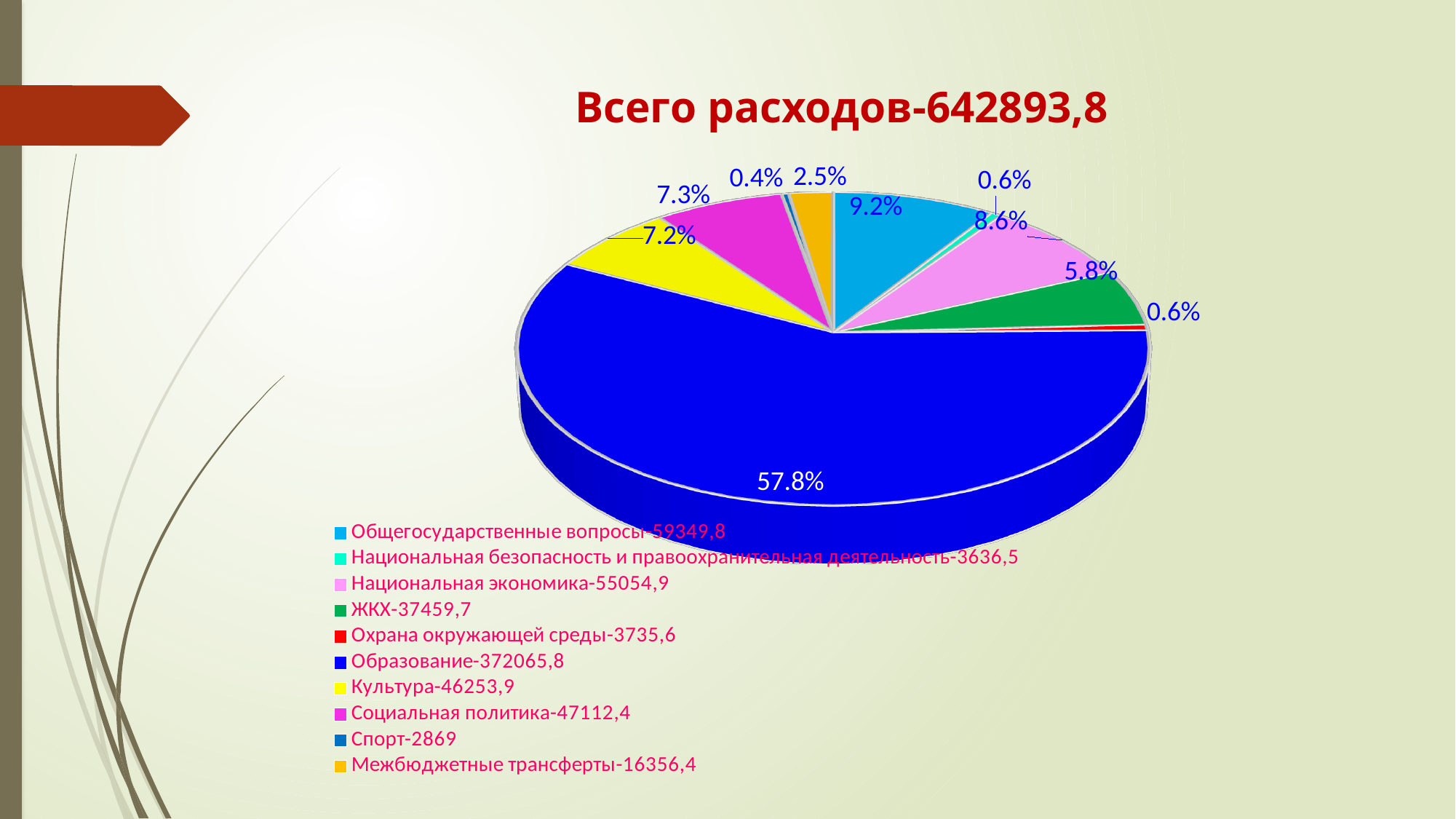
What share of the pie does ЖКХ take? 5.8% Which category has the smallest share of the pie? Спорт Which is larger, the value for Культура or the value for Социальная политика? Социальная политика What colour is the slice for Культура? yellow What is the difference in percentage points between the share of Образование and the share of Общегосударственные вопросы? 48.6% Which category has the largest share of the pie? Образование What value is given for Национальная экономика in the legend? 55054,9 What kind of chart is shown on the slide? pie chart What value is given for Межбюджетные трансферты in the legend? 16356,4 What is the title of the chart? Всего расходов-642893,8 How many categories does the legend of the pie chart list? 10 What share of the pie does Образование take? 57.8%